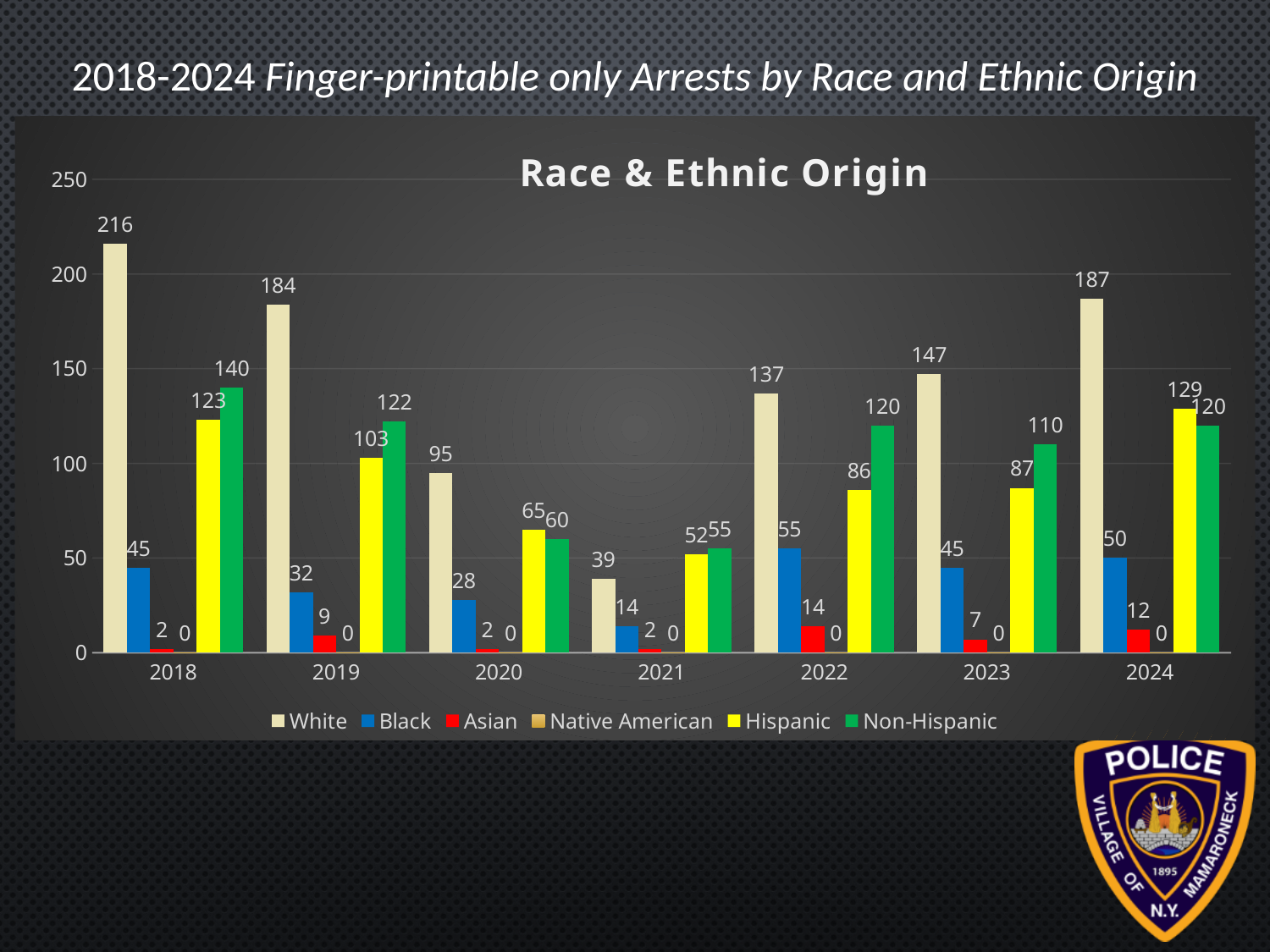
What is the value for Black in 2022? 55 What is the value for Asian in 2019? 9 What is the title of the chart? Race & Ethnic Origin What is the value for White in 2018? 216 In which year is the Non-Hispanic value highest? 2018 How many series does the legend list? 6 In which year is the White value lowest? 2021 What kind of chart is shown? Bar chart What is the difference between the White values for 2018 and 2019? 32 What is the value for Hispanic in 2024? 129 How many years are shown on the x axis? 7 Which is larger in 2020, the Hispanic value or the Non-Hispanic value? Hispanic